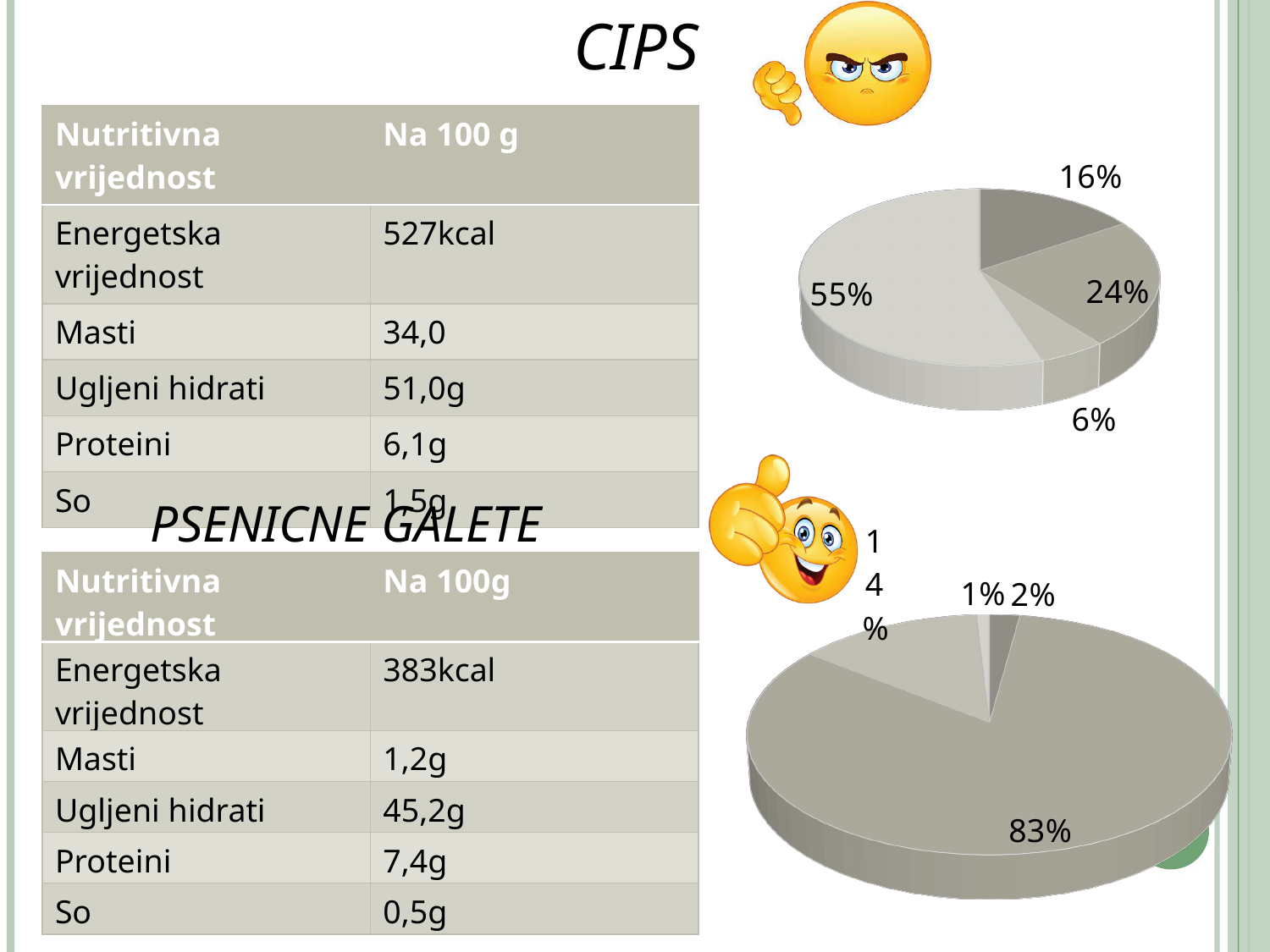
In the top pie chart, what is the percentage of the largest slice? 55% How many slices does the bottom pie chart have? 4 In the bottom pie chart, what is the percentage of the smallest slice? 1% What kind of chart is the top chart on the slide (next to the CIPS table)? pie chart In the bottom pie chart, what is the percentage of the largest slice? 83% In the top pie chart, what is the percentage of the second-largest slice? 24% How many slices does the top pie chart have? 4 In the top pie chart, what is the percentage of the smallest slice? 6% What kind of chart is the bottom chart on the slide (next to the PSENICNE GALETE table)? pie chart Which chart has the larger biggest slice, the top pie chart or the bottom pie chart? the bottom pie chart In the top pie chart, what is the difference in percentage points between the largest slice and the smallest slice? 49 In the bottom pie chart, what is the difference in percentage points between the largest slice and the smallest slice? 82